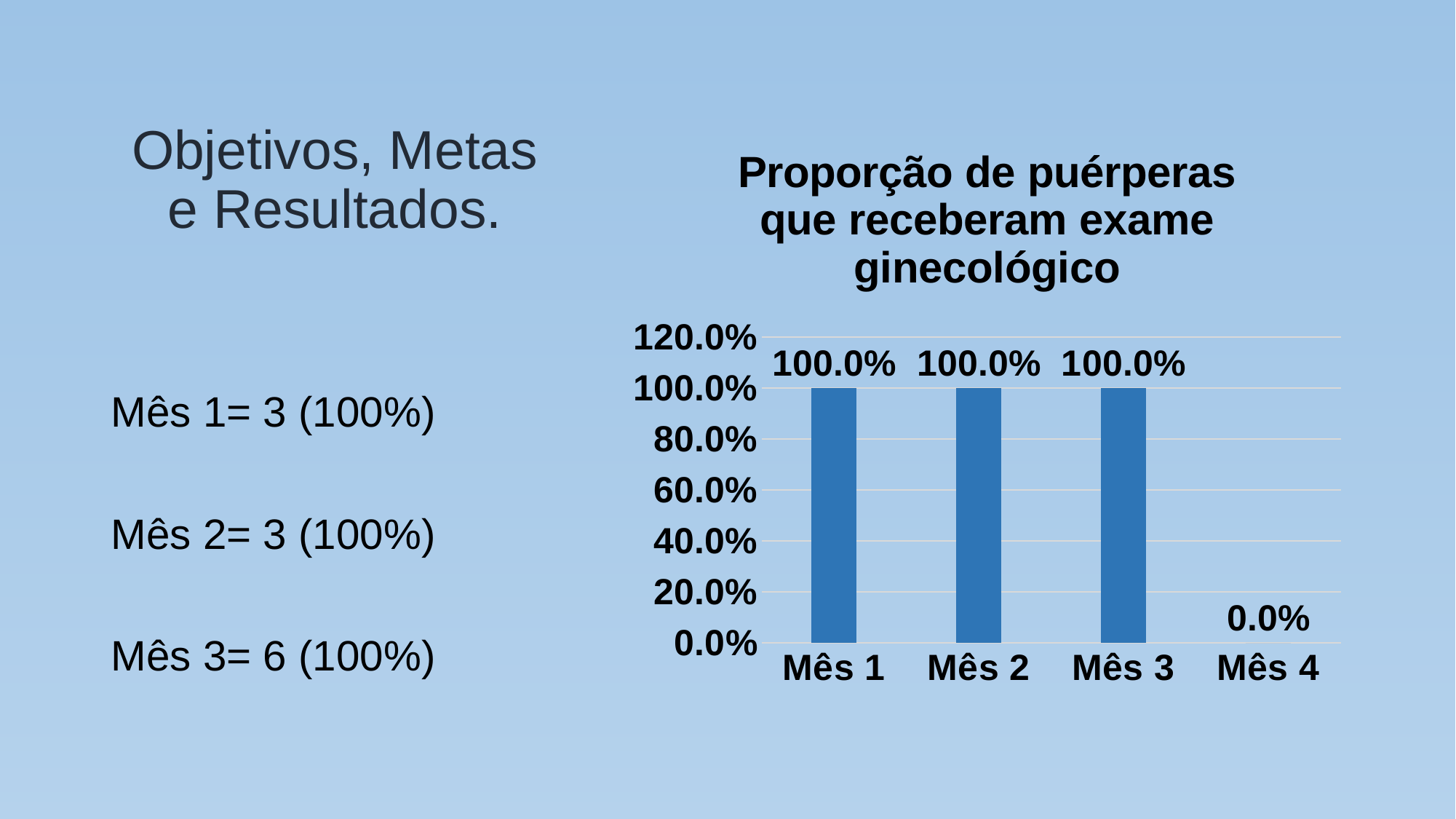
How many categories are shown on the x axis? 4 What is the difference between the values for Mês 2 and Mês 4? 100.0% What is the value for Mês 4? 0.0% What is the value for Mês 1? 100.0% Do the values for Mês 1, Mês 2 and Mês 3 differ from each other? No, all are 100.0% What is the title of the chart? Proporção de puérperas que receberam exame ginecológico What kind of chart is shown on the slide? bar chart What is the highest value shown on the y axis? 120.0% Which is larger, the value for Mês 3 or the value for Mês 4? Mês 3 What is the value for Mês 3? 100.0% Which category has the lowest value? Mês 4 Is the value for Mês 1 greater or less than 80.0%? greater